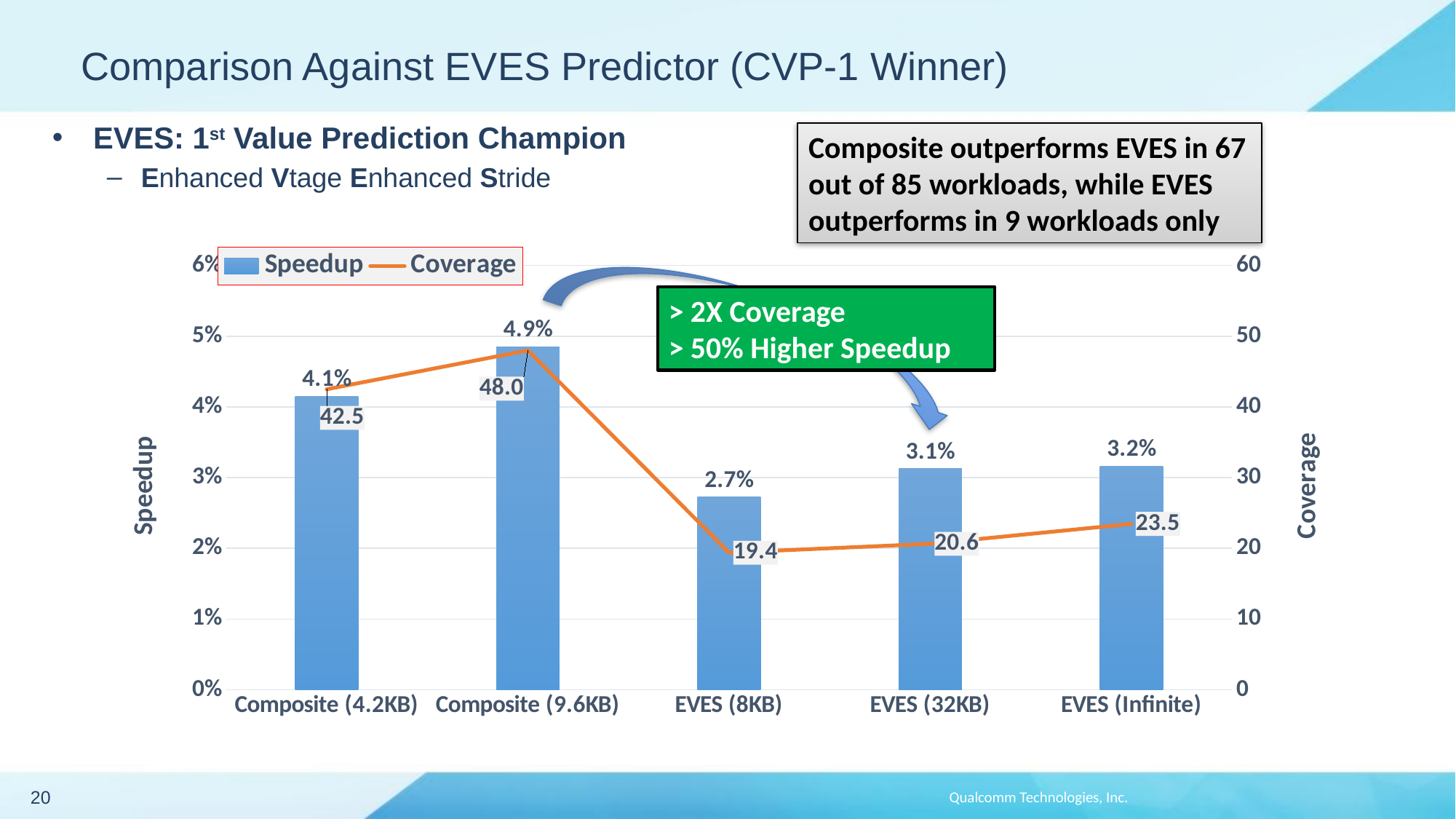
What is the Coverage value for Composite (4.2KB)? 42.5 What is the difference in Coverage between Composite (9.6KB) and EVES (8KB)? 28.6 What kind of chart is used to show the Speedup series? bar chart How many series does the legend list? 2 How many categories are shown on the x axis? 5 Which category has the lowest Coverage? EVES (8KB) What is the Coverage value for EVES (8KB)? 19.4 What is the difference in Speedup between Composite (9.6KB) and Composite (4.2KB)? 0.8% Which has a higher Speedup, EVES (32KB) or EVES (Infinite)? EVES (Infinite) What is the Speedup for Composite (9.6KB)? 4.9% What is the label of the right-hand vertical axis? Coverage Which category has the highest Speedup? Composite (9.6KB)